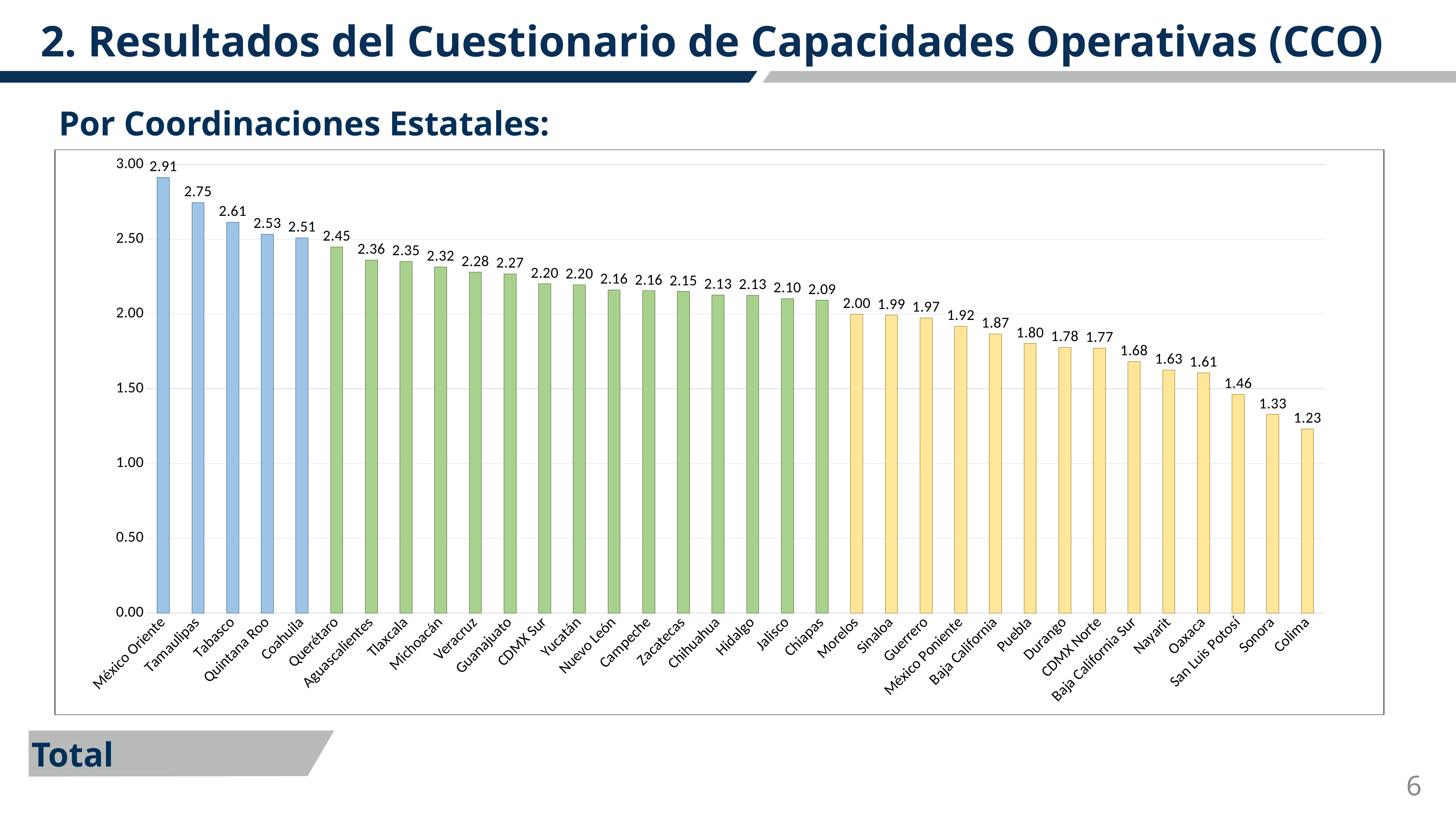
What is the value for San Luis Potosí? 1.46 What is the value for Querétaro? 2.45 Which has a larger value, Veracruz or Puebla? Veracruz What kind of chart is shown on the slide? bar chart What is the difference between the values for México Oriente and Colima? 1.68 What is the value for Morelos? 2.00 Which state coordination has the lowest value? Colima Which state coordination has the highest value? México Oriente What is the difference between the values for Tabasco and Coahuila? 0.10 Is the value for Sonora greater or less than 1.50? less What is the value for Tamaulipas? 2.75 How many state coordinations are shown in the chart? 34